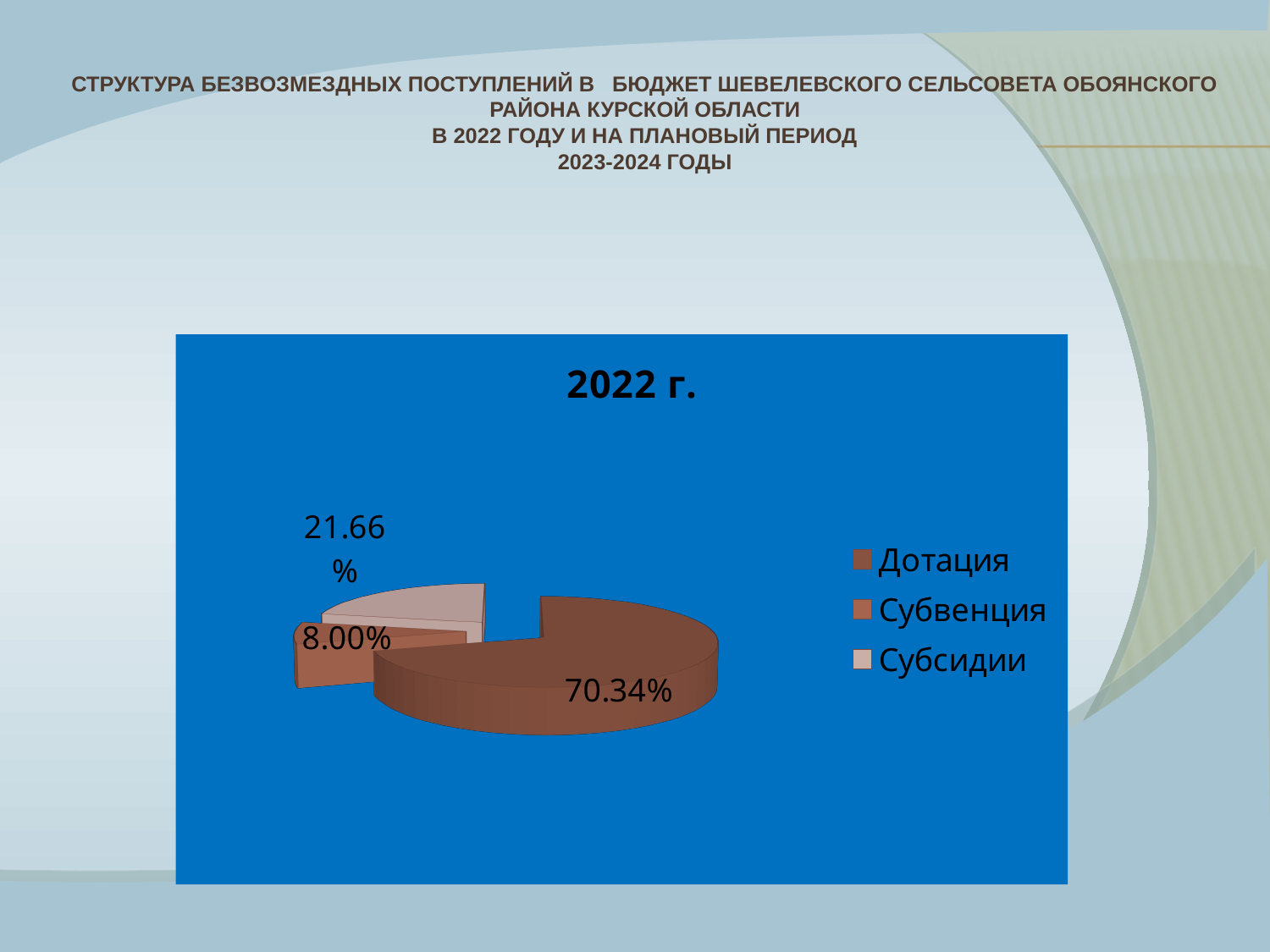
How many entries does the legend list? 3 Which category has the largest slice? Дотация What share of the pie does Субсидии have? 21.66% How many slices does the pie chart have? 3 Which category has the smallest slice? Субвенция What share of the pie does Дотация have? 70.34% What share of the pie does Субвенция have? 8.00% What is the difference between the shares of Дотация and Субсидии? 48.68% What is the chart's title? 2022 г. Which legend entry is shown in the lightest colour? Субсидии Which is larger, the share for Субсидии or the share for Субвенция? Субсидии What kind of chart is shown on the slide? pie chart